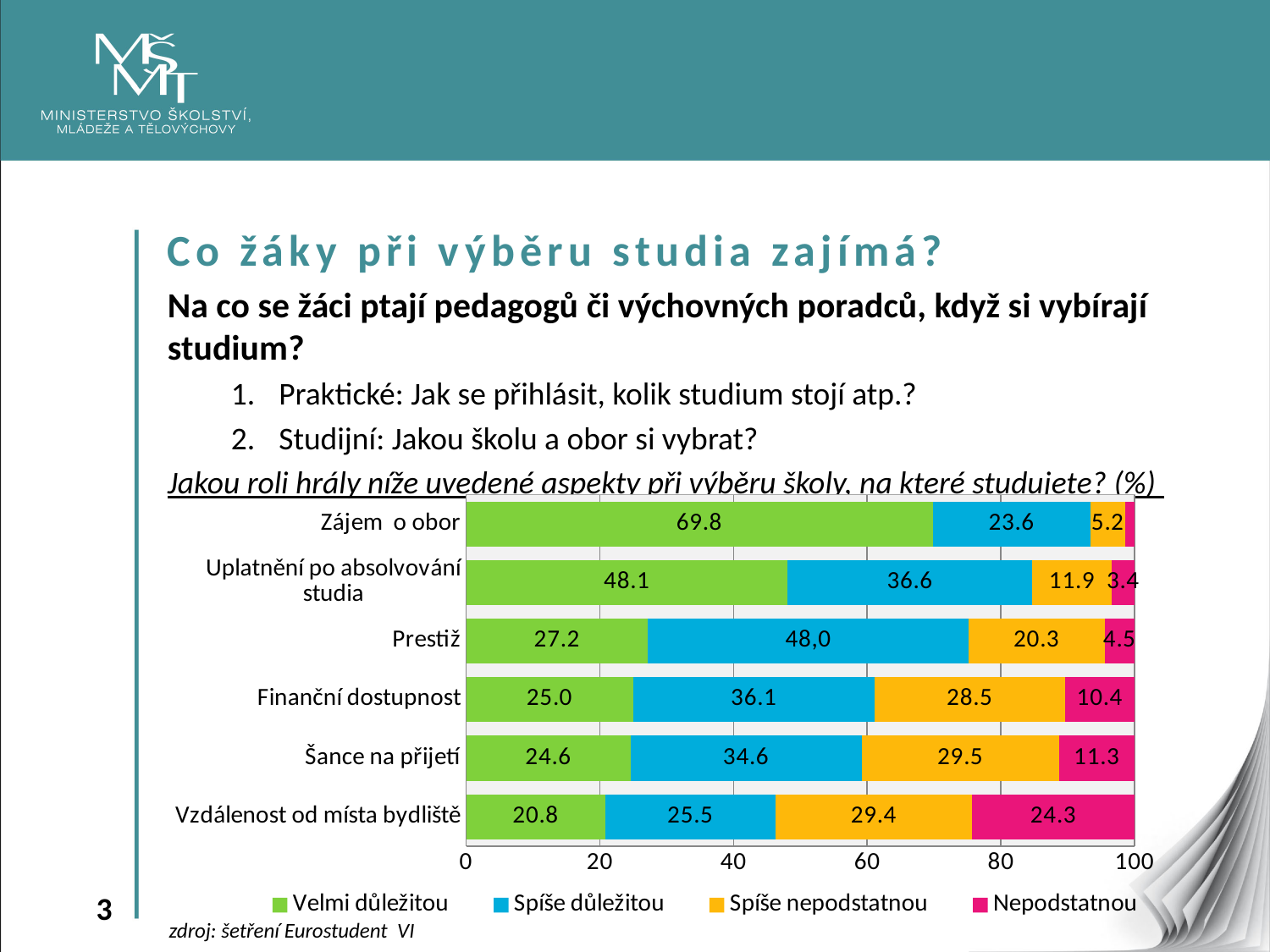
What is the 'Velmi důležitou' value for 'Zájem o obor'? 69.8 Which category has the lowest 'Velmi důležitou' value? Vzdálenost od místa bydliště What is the difference between the 'Velmi důležitou' values for 'Zájem o obor' and 'Uplatnění po absolvování studia'? 21.7 What kind of chart is shown on the slide? stacked bar chart Which is larger: the 'Nepodstatnou' value for 'Finanční dostupnost' or for 'Šance na přijetí'? Šance na přijetí How many categories are plotted on the chart? 6 Which category has the highest 'Velmi důležitou' value? Zájem o obor Which legend entry is shown in green? Velmi důležitou How many series does the legend list? 4 What is the 'Nepodstatnou' value for 'Vzdálenost od místa bydliště'? 24.3 What is the 'Spíše důležitou' value for 'Uplatnění po absolvování studia'? 36.6 What is the 'Spíše nepodstatnou' value for 'Šance na přijetí'? 29.5